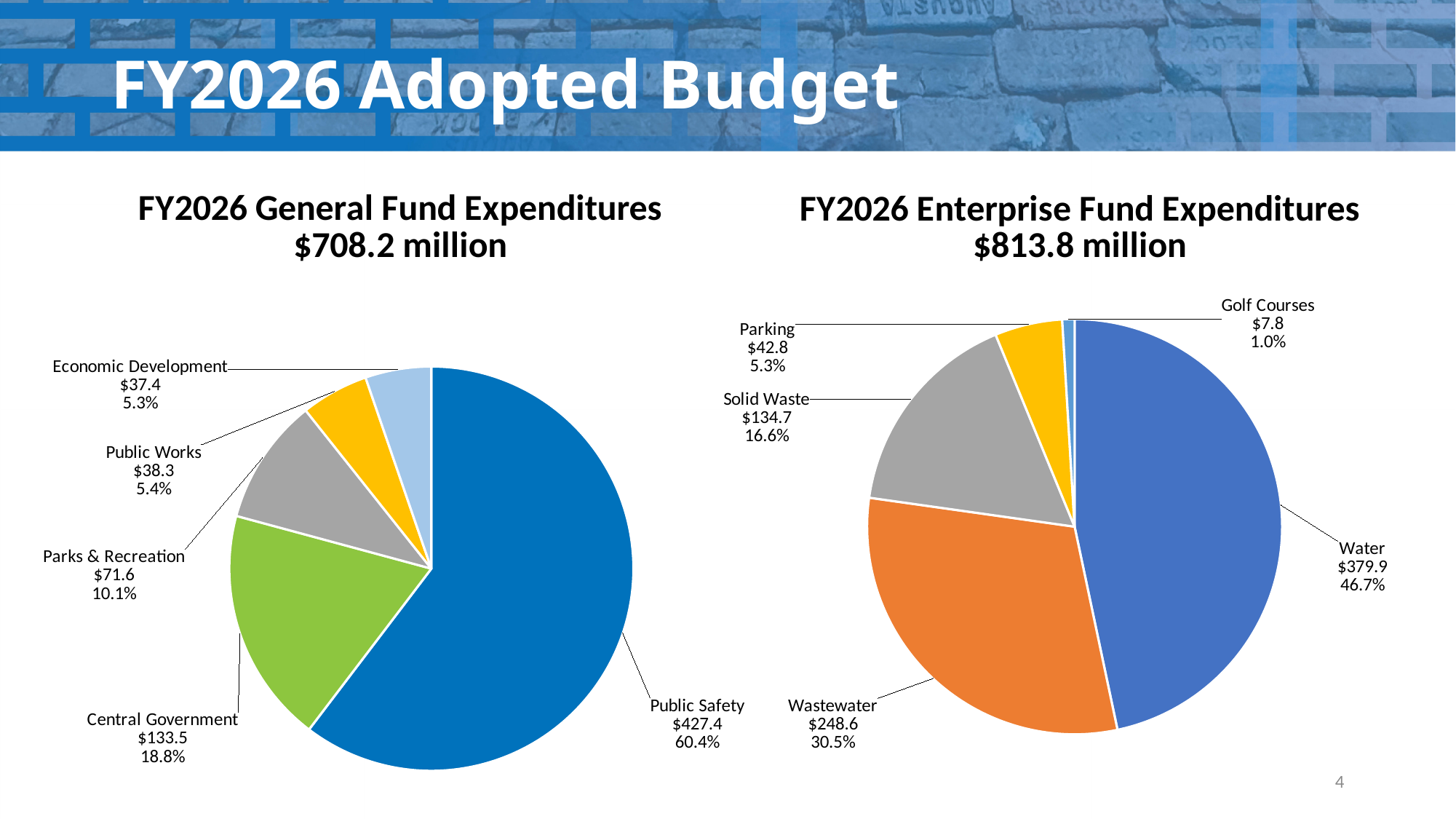
In the FY2026 General Fund Expenditures chart, what is the difference between the Central Government and Parks & Recreation values? $61.9 In the FY2026 Enterprise Fund Expenditures chart, what is the difference between the Water and Wastewater values? $131.3 In the FY2026 Enterprise Fund Expenditures chart, what share of the pie does Wastewater represent? 30.5% In the FY2026 General Fund Expenditures chart, which category has the largest slice? Public Safety In the FY2026 Enterprise Fund Expenditures chart, which category has the smallest slice? Golf Courses What total amount is stated in the title of the FY2026 Enterprise Fund Expenditures chart? $813.8 million In the FY2026 General Fund Expenditures chart, what is the value for Public Safety? $427.4 What type of chart is the FY2026 General Fund Expenditures chart? Pie chart How many categories are shown in the FY2026 Enterprise Fund Expenditures chart? 5 In the FY2026 General Fund Expenditures chart, which is larger: Public Works or Economic Development? Public Works In the FY2026 General Fund Expenditures chart, what share of the pie does Central Government represent? 18.8% In the FY2026 Enterprise Fund Expenditures chart, what is the value for Solid Waste? $134.7